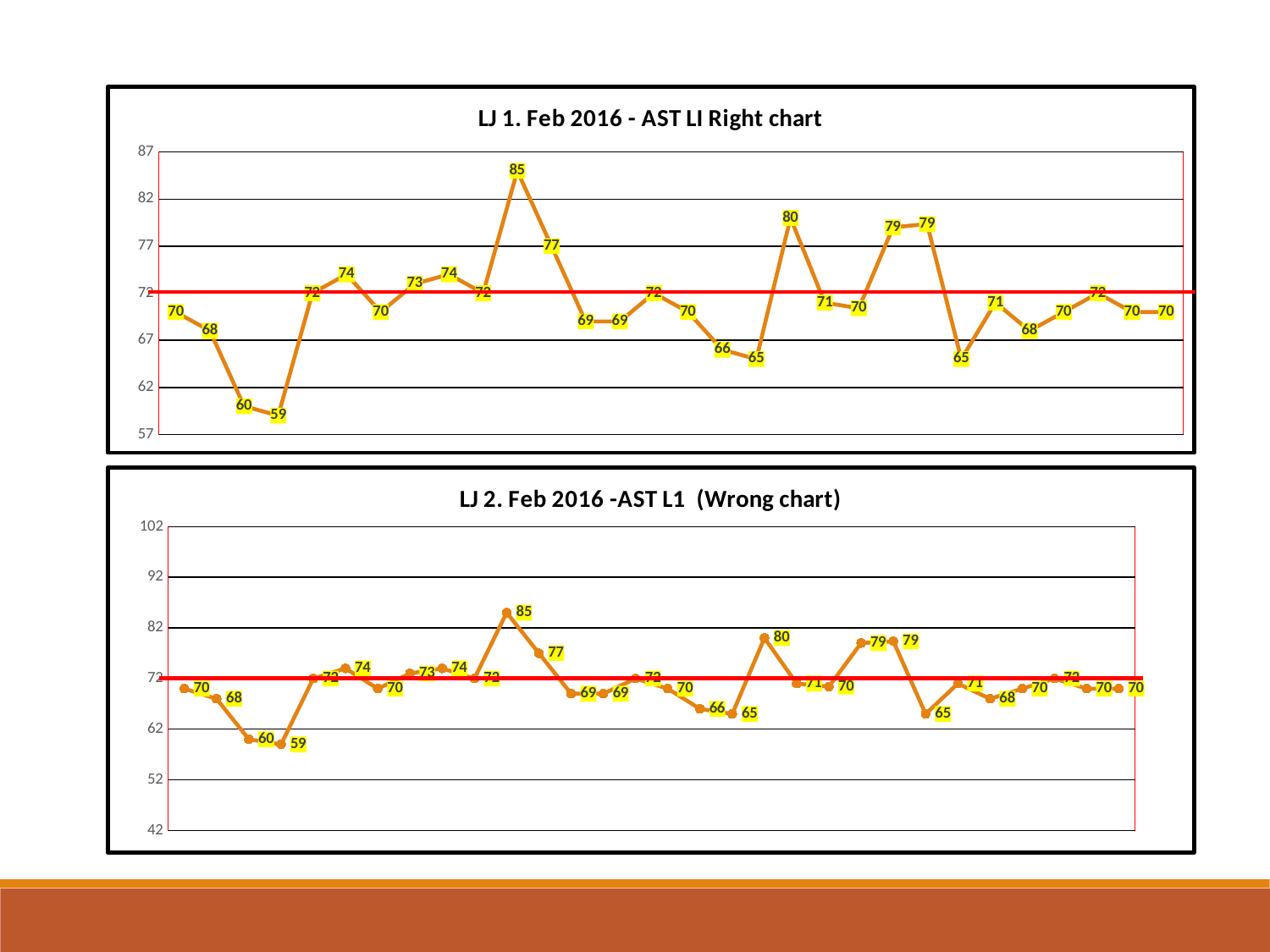
In the top chart 'LJ 1. Feb 2016 - AST LI Right chart', what is the value of the first data point on the left? 70 In the bottom chart 'LJ 2. Feb 2016 -AST L1 (Wrong chart)', which is larger: the peak labelled 85 or the peak labelled 80? 85 In the bottom chart 'LJ 2. Feb 2016 -AST L1 (Wrong chart)', what is the lowest value shown on the vertical axis? 42 In the top chart 'LJ 1. Feb 2016 - AST LI Right chart', what is the highest data label value? 85 In the bottom chart 'LJ 2. Feb 2016 -AST L1 (Wrong chart)', what is the difference between the highest value (85) and the lowest value (59)? 26 In the top chart 'LJ 1. Feb 2016 - AST LI Right chart', what is the highest value shown on the vertical axis? 87 In the bottom chart 'LJ 2. Feb 2016 -AST L1 (Wrong chart)', is the data point labelled 59 greater or less than 62 on the axis? less In the top chart 'LJ 1. Feb 2016 - AST LI Right chart', what is the lowest data label value? 59 In the top chart 'LJ 1. Feb 2016 - AST LI Right chart', is the data point labelled 85 greater or less than 82 on the axis? greater How many data points are plotted on the line in the top chart 'LJ 1. Feb 2016 - AST LI Right chart'? 30 In the top chart 'LJ 1. Feb 2016 - AST LI Right chart', what is the value of the last data point on the right? 70 What kind of chart is the top chart titled 'LJ 1. Feb 2016 - AST LI Right chart'? line chart